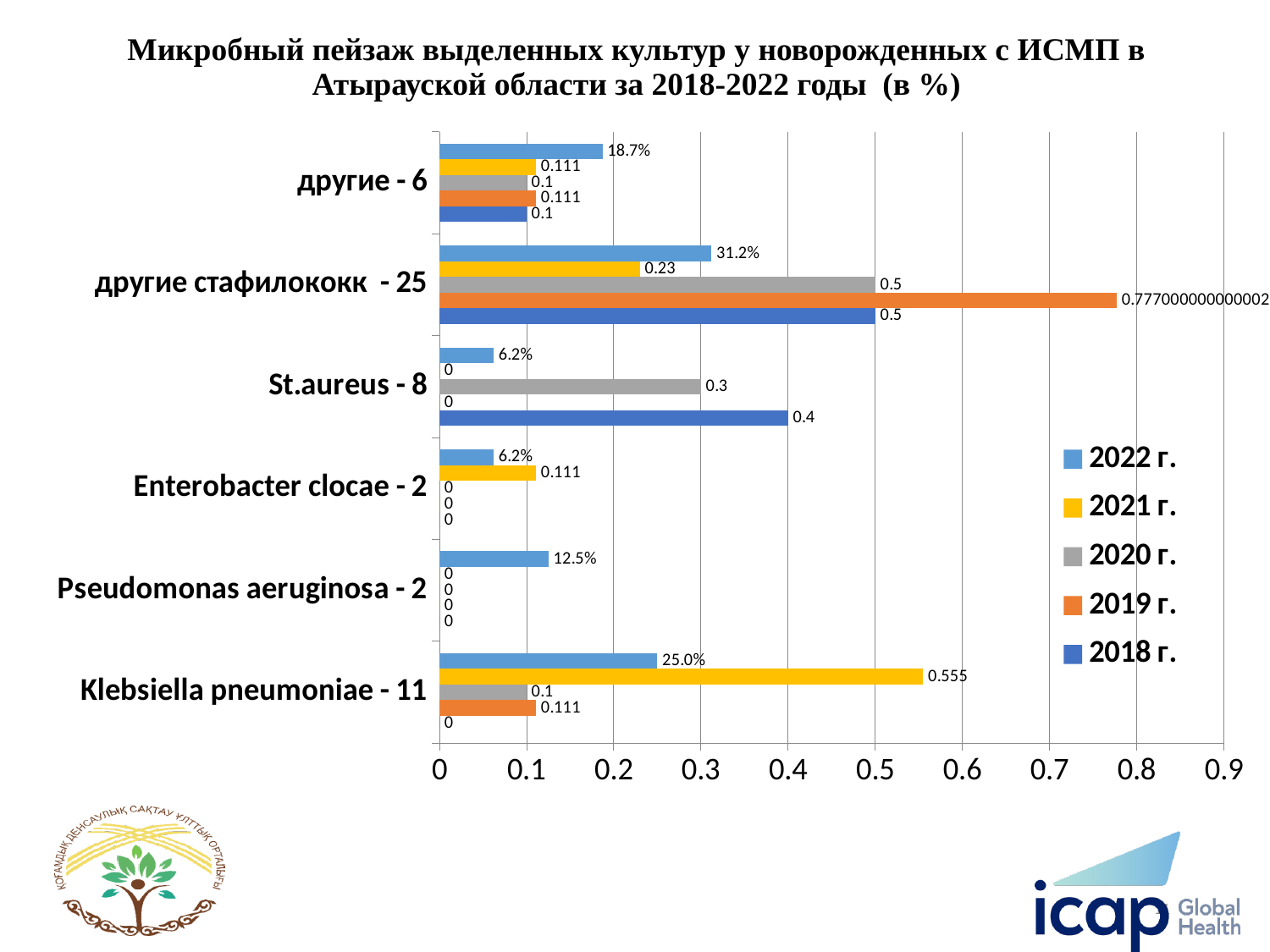
Which category has the highest 2021 г. value? Klebsiella pneumoniae - 11 How many series does the legend list? 5 Which category has the highest 2022 г. value? другие стафилококк - 25 Which is larger for другие стафилококк - 25: the 2020 г. value or the 2021 г. value? 2020 г. What is the 2022 г. value for другие стафилококк - 25? 31.2% What is the difference between the 2018 г. value for St.aureus - 8 and its 2020 г. value? 0.1 What is the 2021 г. value for Klebsiella pneumoniae - 11? 0.555 Is the 2019 г. value for другие стафилококк - 25 greater or less than 0.7? greater How many categories are shown on the chart? 6 What kind of chart is shown on the slide? bar chart What is the 2018 г. value for St.aureus - 8? 0.4 What is the 2019 г. value for другие стафилококк - 25? 0.777000000000002